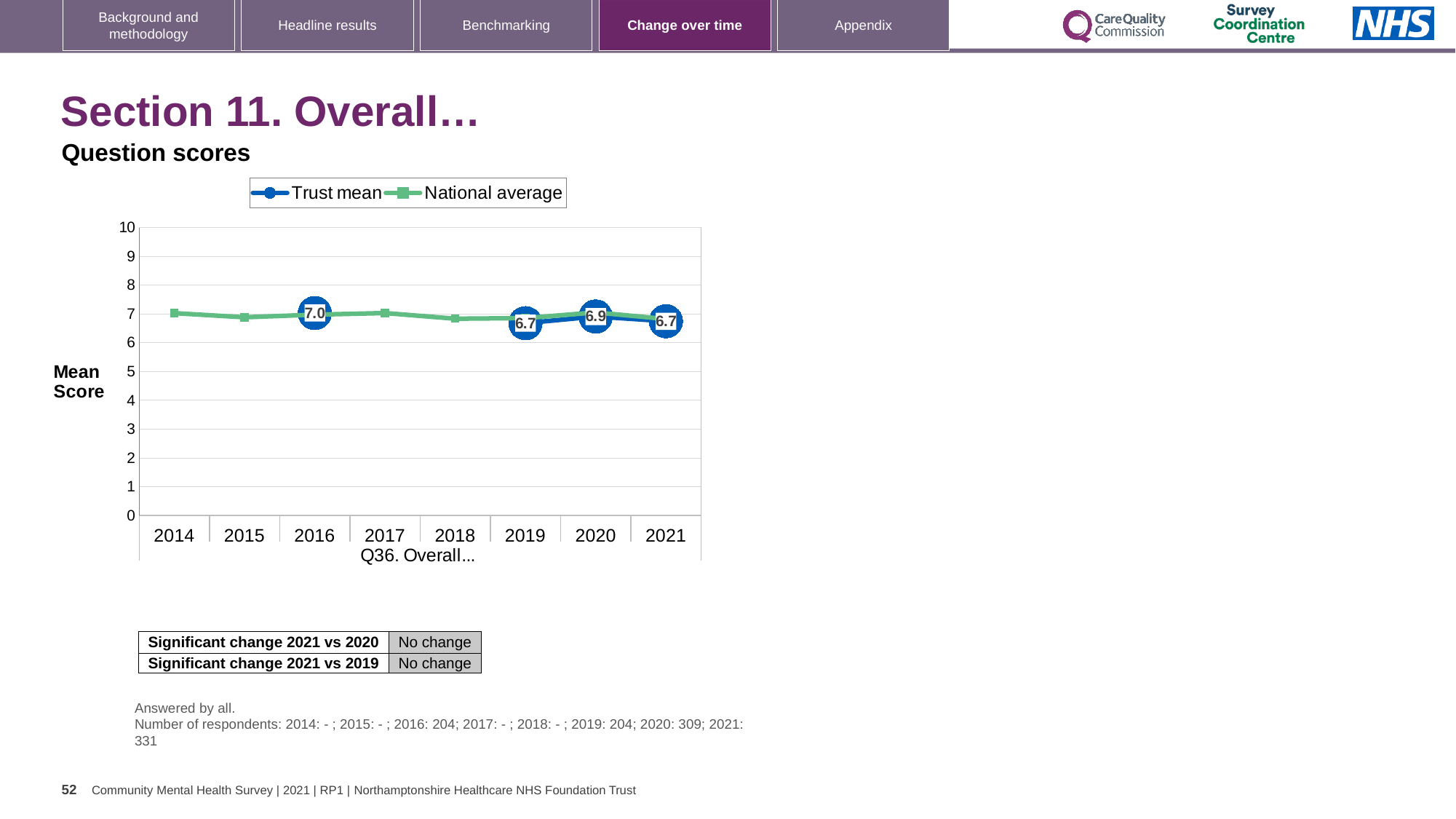
What is the Trust mean score for 2016? 7.0 Which year has the larger Trust mean score, 2019 or 2020? 2020 What is the difference between the Trust mean score in 2016 and in 2021? 0.3 What is the Trust mean score for 2020? 6.9 How many years are shown on the x axis? 8 What is the Trust mean score for 2021? 6.7 What kind of chart is shown on the slide? Line chart In which year is the labelled Trust mean score highest? 2016 How many series does the legend list? 2 Does the Trust mean score rise or fall from 2020 to 2021? Fall What is the label on the vertical axis of the chart? Mean Score Is the National average value for 2014 greater or less than 5? greater